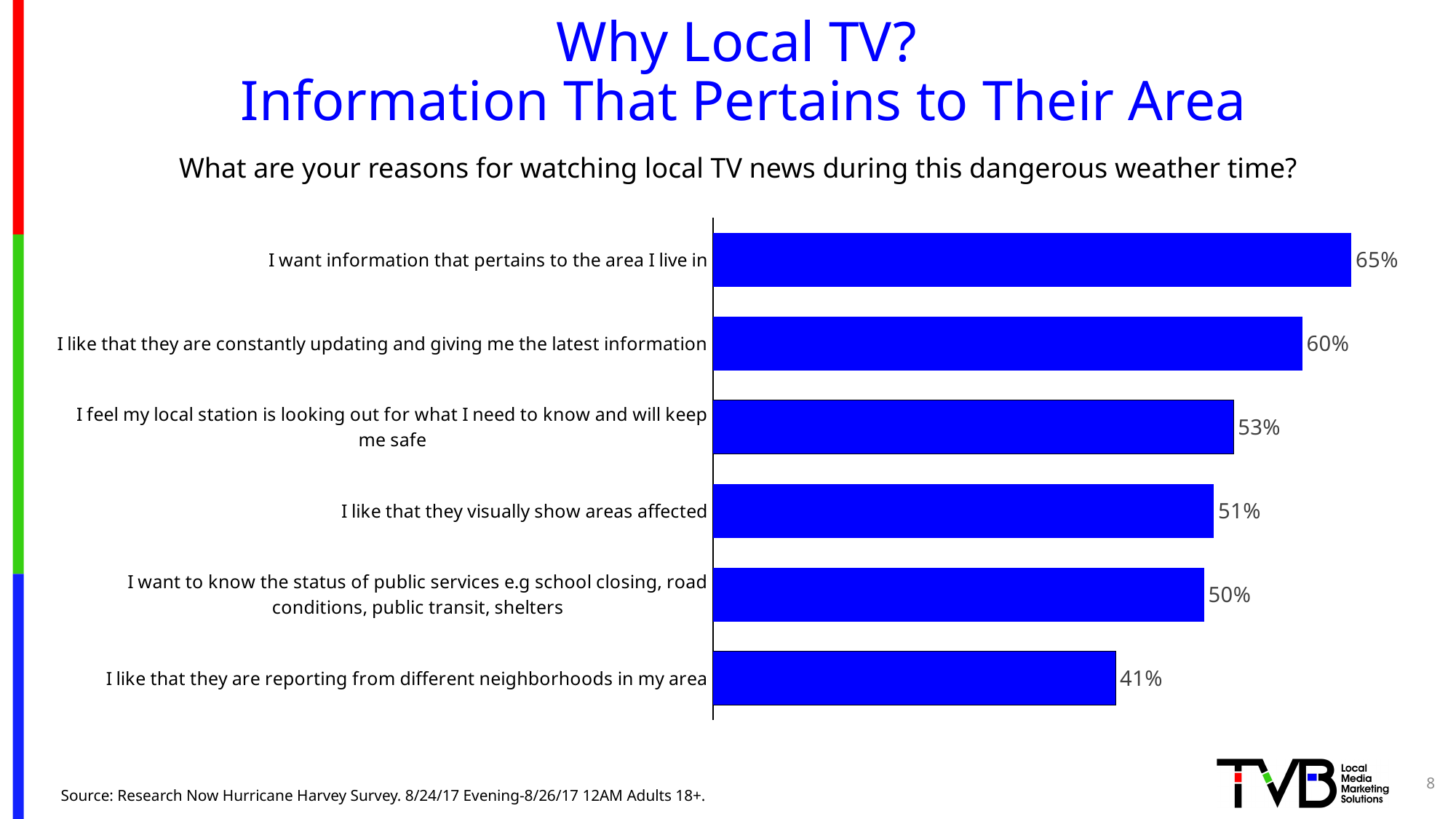
How many reasons are plotted in the chart? 6 What percentage of respondents said "I want information that pertains to the area I live in"? 65% What is the value for "I like that they are reporting from different neighborhoods in my area"? 41% What is the value for "I feel my local station is looking out for what I need to know and will keep me safe"? 53% What percentage chose "I like that they visually show areas affected"? 51% Which reason has the lowest percentage? I like that they are reporting from different neighborhoods in my area Which is larger: the value for "I like that they visually show areas affected" or the value for "I want to know the status of public services"? I like that they visually show areas affected What survey question is the chart based on? What are your reasons for watching local TV news during this dangerous weather time? What kind of chart is shown on the slide? Bar chart How much higher is "I like that they are constantly updating and giving me the latest information" than "I want to know the status of public services"? 10% What is the difference between the highest and lowest percentages shown? 24% Which reason has the highest percentage? I want information that pertains to the area I live in